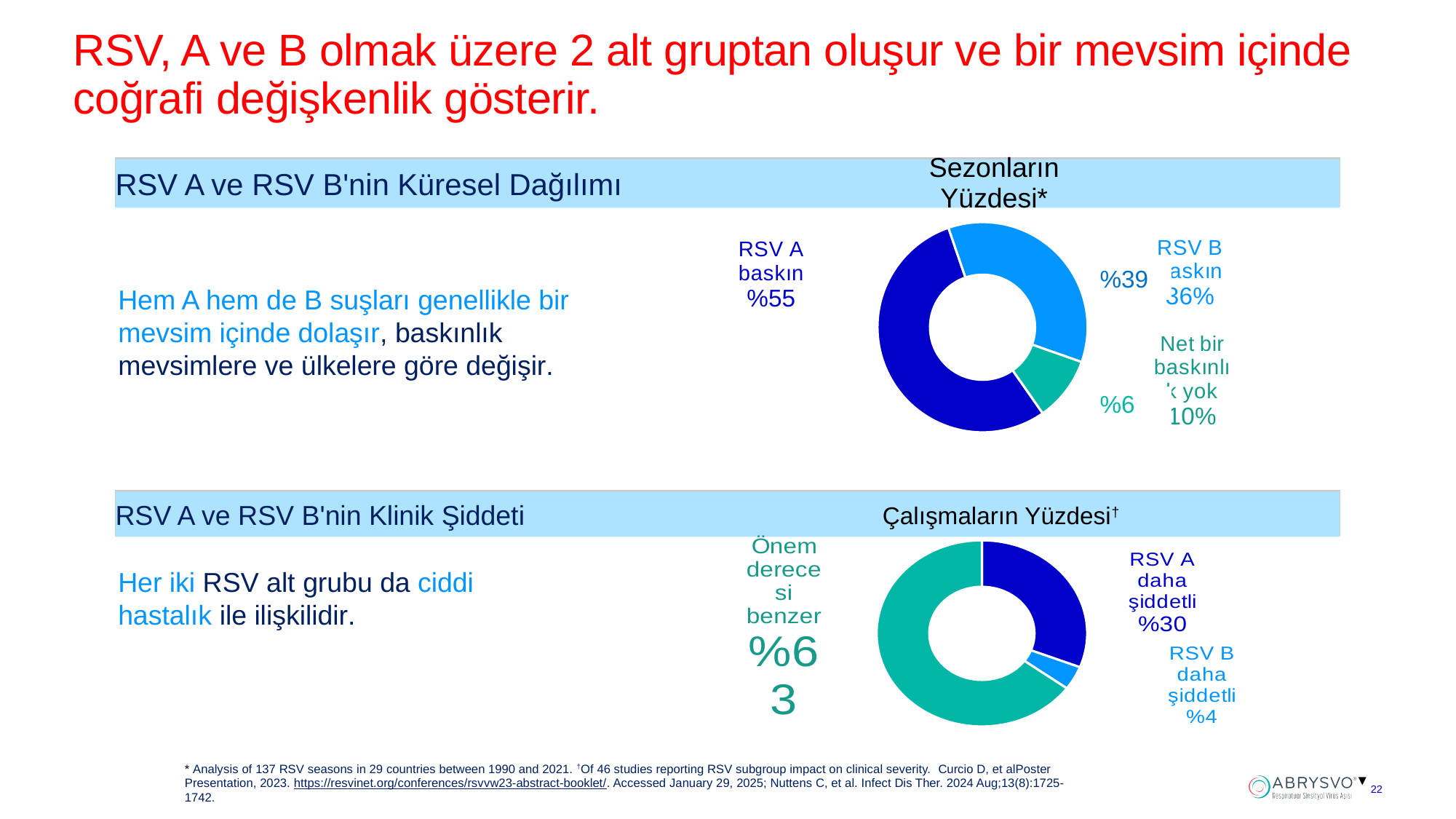
In the 'Çalışmaların Yüzdesi' chart, which category has the smallest slice? RSV B daha şiddetli In the 'Çalışmaların Yüzdesi' chart, what percentage is shown for 'Önem derecesi benzer'? %63 In the 'Çalışmaların Yüzdesi' chart, what is the difference between 'Önem derecesi benzer' and 'RSV A daha şiddetli'? 33 percentage points How many slices does the 'Sezonların Yüzdesi*' chart have? 3 What kind of chart is used for 'Sezonların Yüzdesi*' on the slide? pie chart (donut) In the 'Çalışmaların Yüzdesi' chart, what percentage is shown for 'RSV B daha şiddetli'? %4 In the 'Çalışmaların Yüzdesi' chart, what percentage is shown for 'RSV A daha şiddetli'? %30 In the 'Sezonların Yüzdesi*' chart, what percentage is shown for 'RSV A baskın'? %55 How many slices does the 'Çalışmaların Yüzdesi' chart have? 3 In the 'Sezonların Yüzdesi*' chart, which category has the smallest slice? Net bir baskınlık yok In the 'Sezonların Yüzdesi*' chart, which slice is larger: 'RSV A baskın' or 'RSV B baskın'? RSV A baskın In the 'Sezonların Yüzdesi*' chart, which category has the largest slice? RSV A baskın